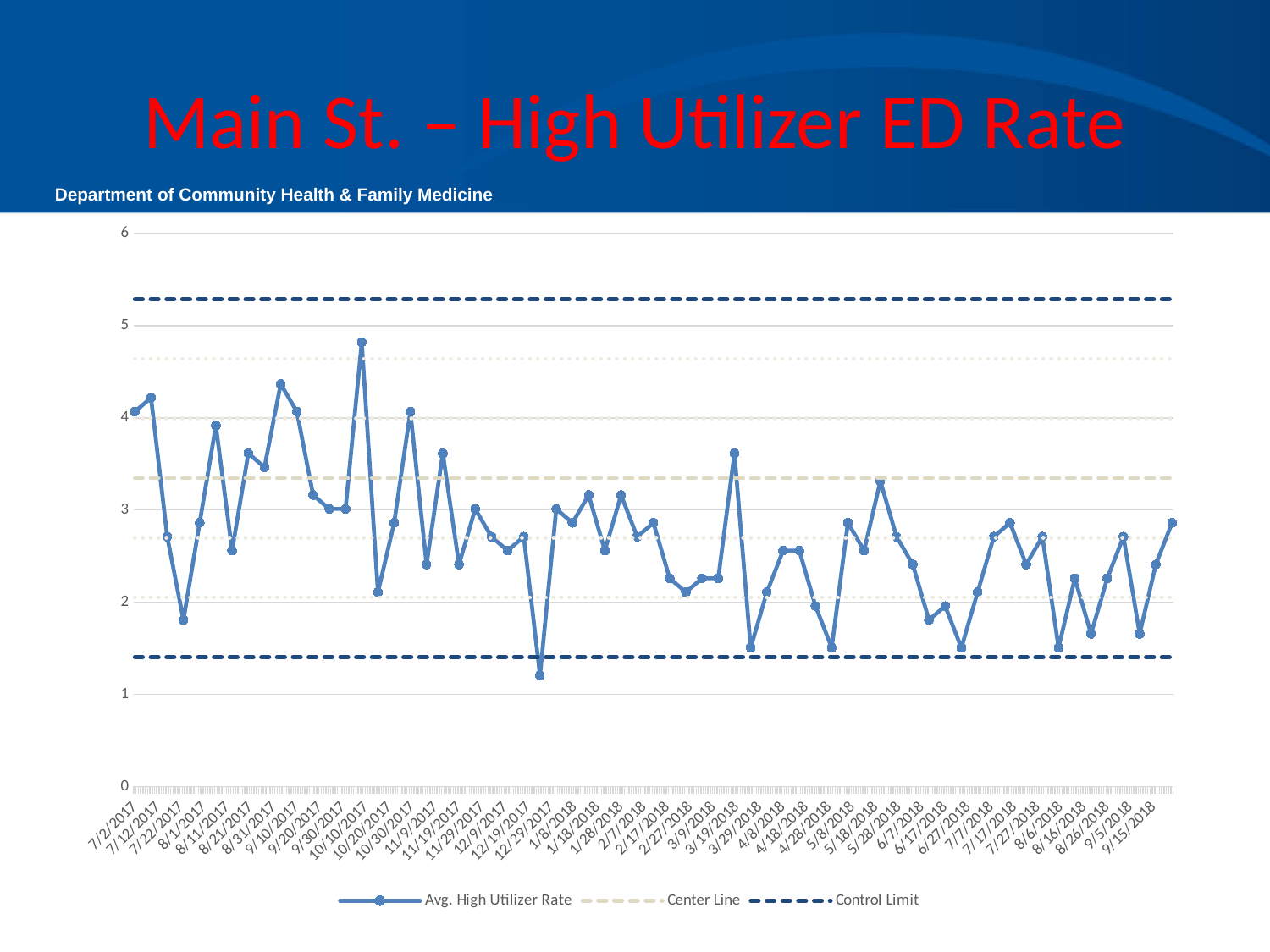
Which is larger, the Avg. High Utilizer Rate on 7/2/2017 or on 3/29/2018? 7/2/2017 Overall, does the Avg. High Utilizer Rate rise or fall from 7/2/2017 to 9/15/2018? fall What is the title of the chart on the slide? Main St. – High Utilizer ED Rate What kind of chart is shown on the slide? Line chart How many series does the legend list? 3 Is the Avg. High Utilizer Rate on 10/10/2017 greater or less than 4? greater Which series is drawn as a solid blue line with markers, according to the legend? Avg. High Utilizer Rate